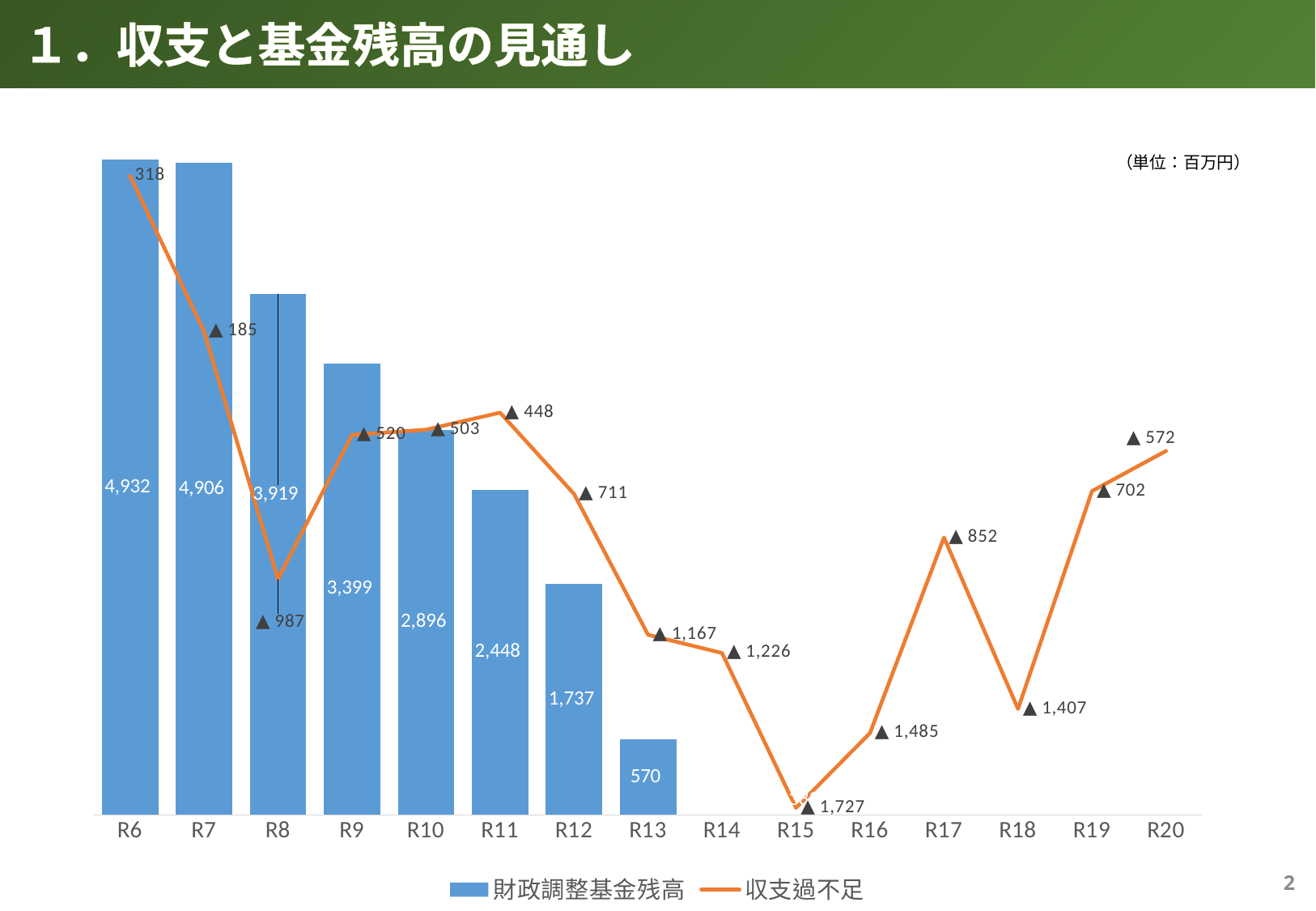
What is the 収支過不足 value for R15? ▲ 1,727 What kind of chart is shown on the slide? Combination bar and line chart What is the difference between the 財政調整基金残高 for R6 and for R13? 4,362 How many years have a 財政調整基金残高 bar plotted? 8 What is the 収支過不足 value for R20? ▲ 572 Which is larger, the 財政調整基金残高 for R11 or for R12? R11 Do the 財政調整基金残高 bars rise or fall from R6 to R13? Fall What is the 財政調整基金残高 value for R9? 3,399 What unit is stated for the values in the chart? 百万円 Which year has the highest 財政調整基金残高? R6 Which year has the lowest 財政調整基金残高 among the bars shown? R13 How many series does the legend list? 2